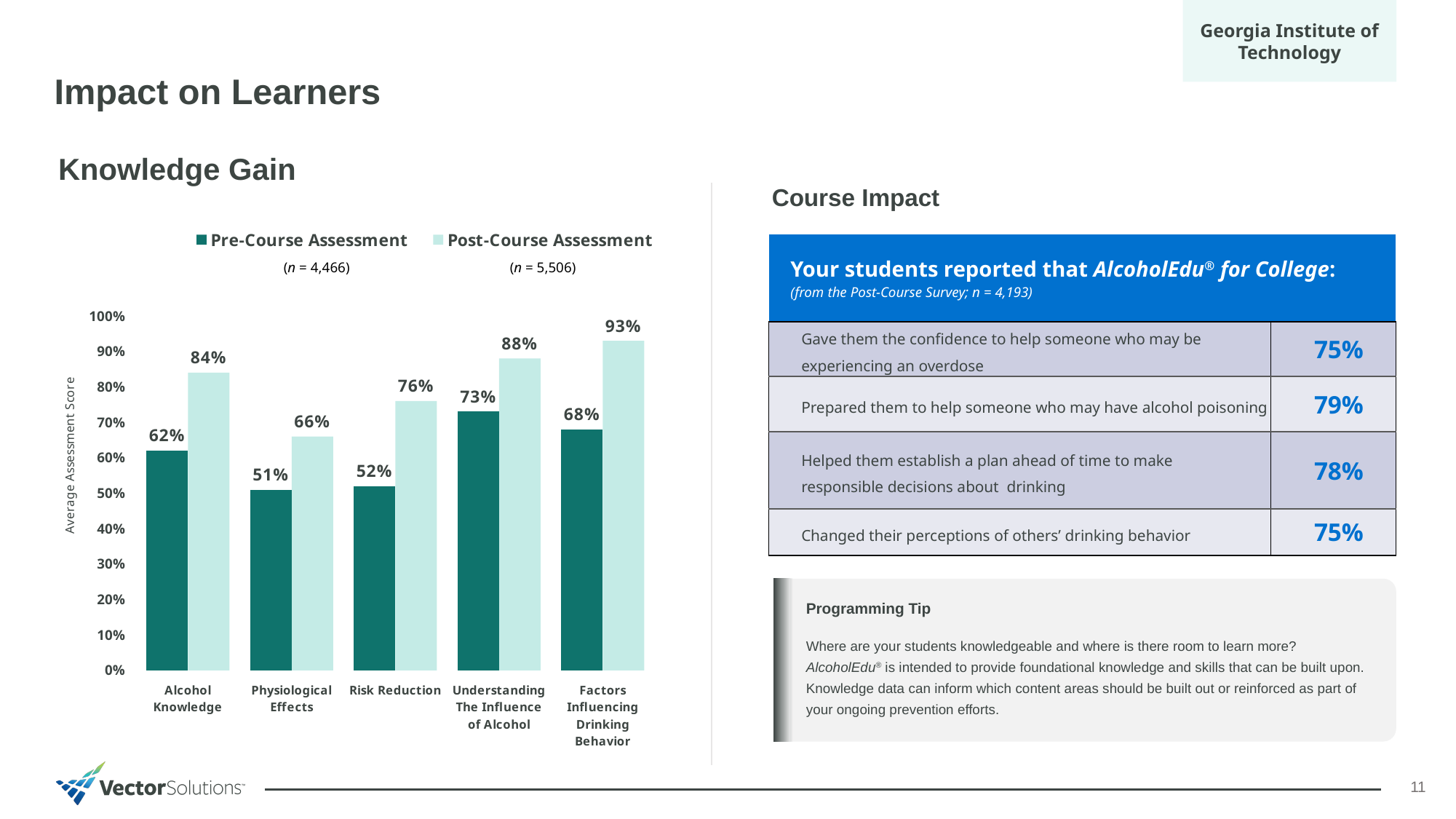
How many series does the chart legend list? 2 What sample size (n) is given for the Post-Course Assessment series in the legend? n = 5,506 Which category has the lowest Pre-Course Assessment value? Physiological Effects What is the label of the y axis of the chart? Average Assessment Score What is the Post-Course Assessment value for Risk Reduction? 76% What kind of chart is shown on the slide? Bar chart What is the difference between the Post-Course and Pre-Course Assessment values for Understanding The Influence of Alcohol? 15% How many categories are shown on the x axis of the chart? 5 Which is larger: the Pre-Course Assessment value for Risk Reduction or the Pre-Course Assessment value for Factors Influencing Drinking Behavior? Factors Influencing Drinking Behavior Which category has the highest Post-Course Assessment value? Factors Influencing Drinking Behavior What is the Post-Course Assessment value for Factors Influencing Drinking Behavior? 93% What is the Pre-Course Assessment value for Alcohol Knowledge? 62%